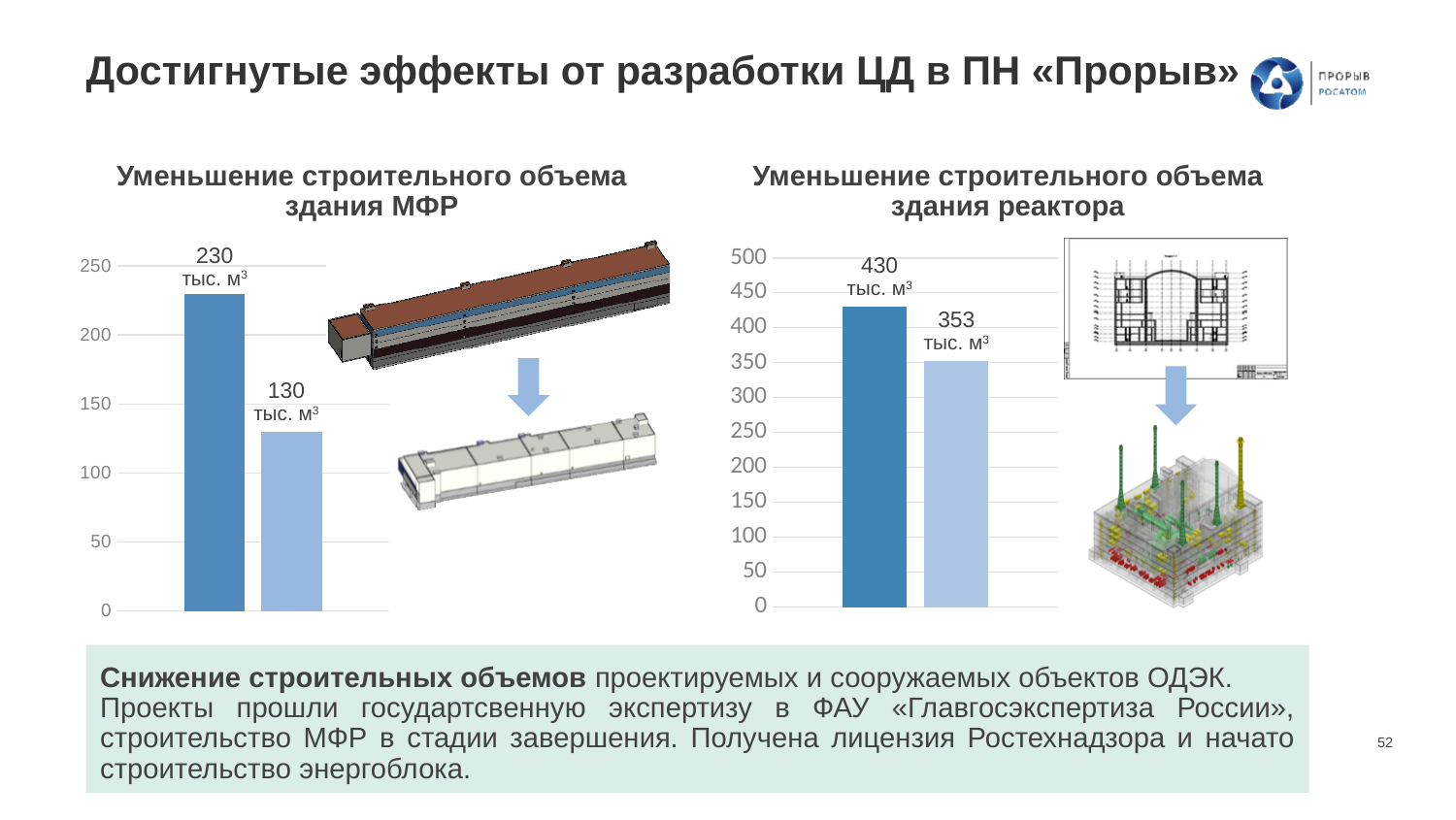
On the chart titled «Уменьшение строительного объема здания МФР», is the value of the light blue bar greater or less than 150? less On the chart titled «Уменьшение строительного объема здания МФР», what is the difference between the first and second bars? 100 тыс. м³ On the chart titled «Уменьшение строительного объема здания реактора», what is the value of the second (light blue) bar? 353 тыс. м³ How many bars are plotted on the chart titled «Уменьшение строительного объема здания МФР»? 2 On the chart titled «Уменьшение строительного объема здания реактора», is the value of the dark blue bar greater or less than 400? greater On the chart titled «Уменьшение строительного объема здания реактора», what is the difference between the first and second bars? 77 тыс. м³ What is the title of the chart on the right side of the slide? Уменьшение строительного объема здания реактора What type of chart is used on the left side of the slide, titled «Уменьшение строительного объема здания МФР»? bar chart On the chart titled «Уменьшение строительного объема здания реактора», what is the value of the first (dark blue) bar? 430 тыс. м³ On the chart titled «Уменьшение строительного объема здания реактора», which bar is taller, the dark blue one or the light blue one? the dark blue one On the chart titled «Уменьшение строительного объема здания МФР», what is the value of the second (light blue) bar? 130 тыс. м³ On the chart titled «Уменьшение строительного объема здания МФР», what is the value of the first (dark blue) bar? 230 тыс. м³